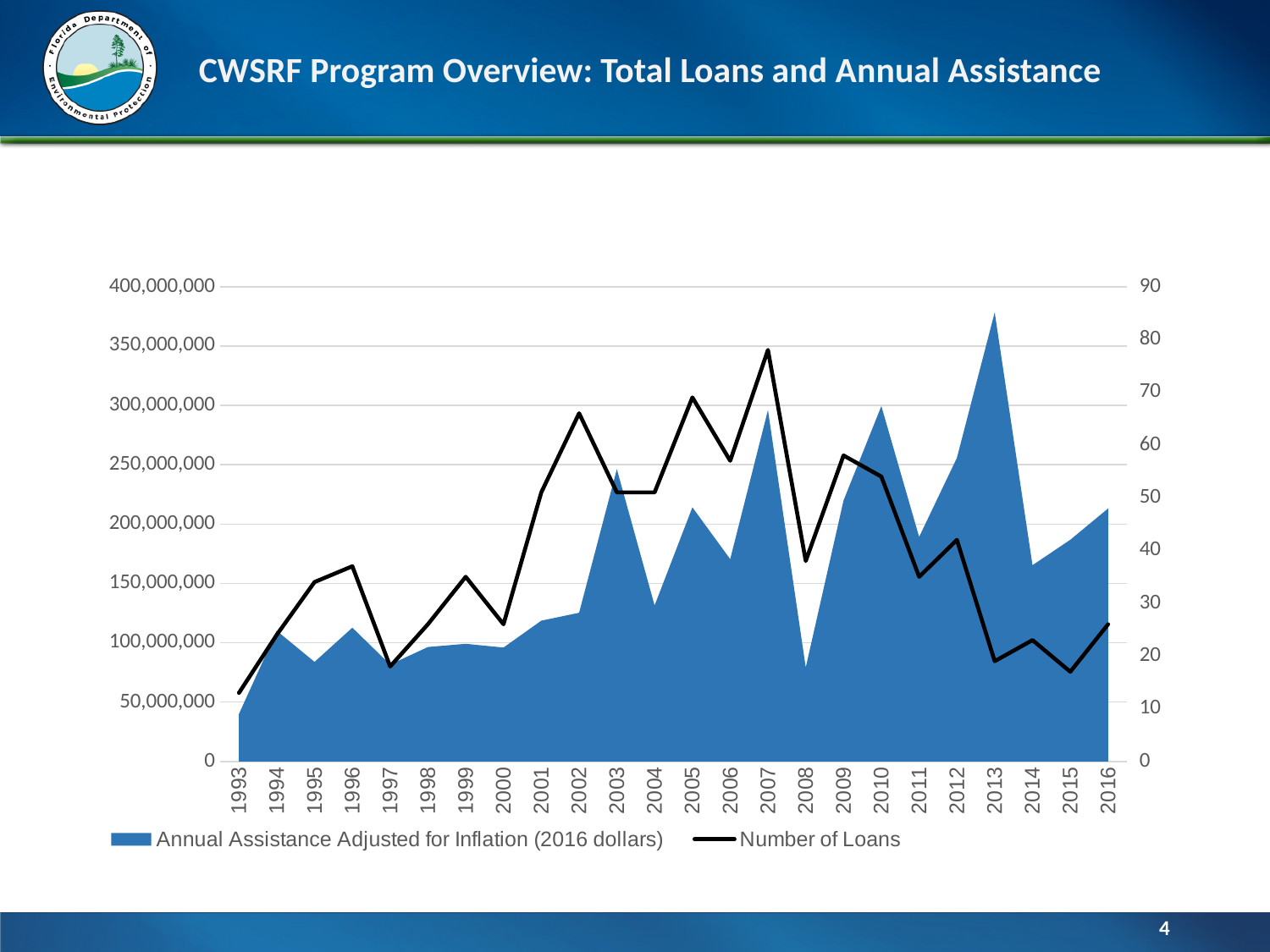
Is the Number of Loans value for 2007 greater or less than 70? greater What kind of chart is used to show the Annual Assistance Adjusted for Inflation series? Area chart In which year is the Number of Loans highest? 2007 Does the Number of Loans rise or fall from 2010 to 2013? fall In which year is the Number of Loans lowest? 1993 Is the Annual Assistance Adjusted for Inflation value for 2013 greater or less than 350,000,000? greater What are the two series named in the chart's legend? Annual Assistance Adjusted for Inflation (2016 dollars) and Number of Loans How many series does the chart's legend list? 2 In which year is Annual Assistance Adjusted for Inflation (2016 dollars) lowest? 1993 In which year is Annual Assistance Adjusted for Inflation (2016 dollars) highest? 2013 Which year has the larger Annual Assistance Adjusted for Inflation value, 2003 or 2004? 2003 How many years are shown along the x axis of the chart? 24